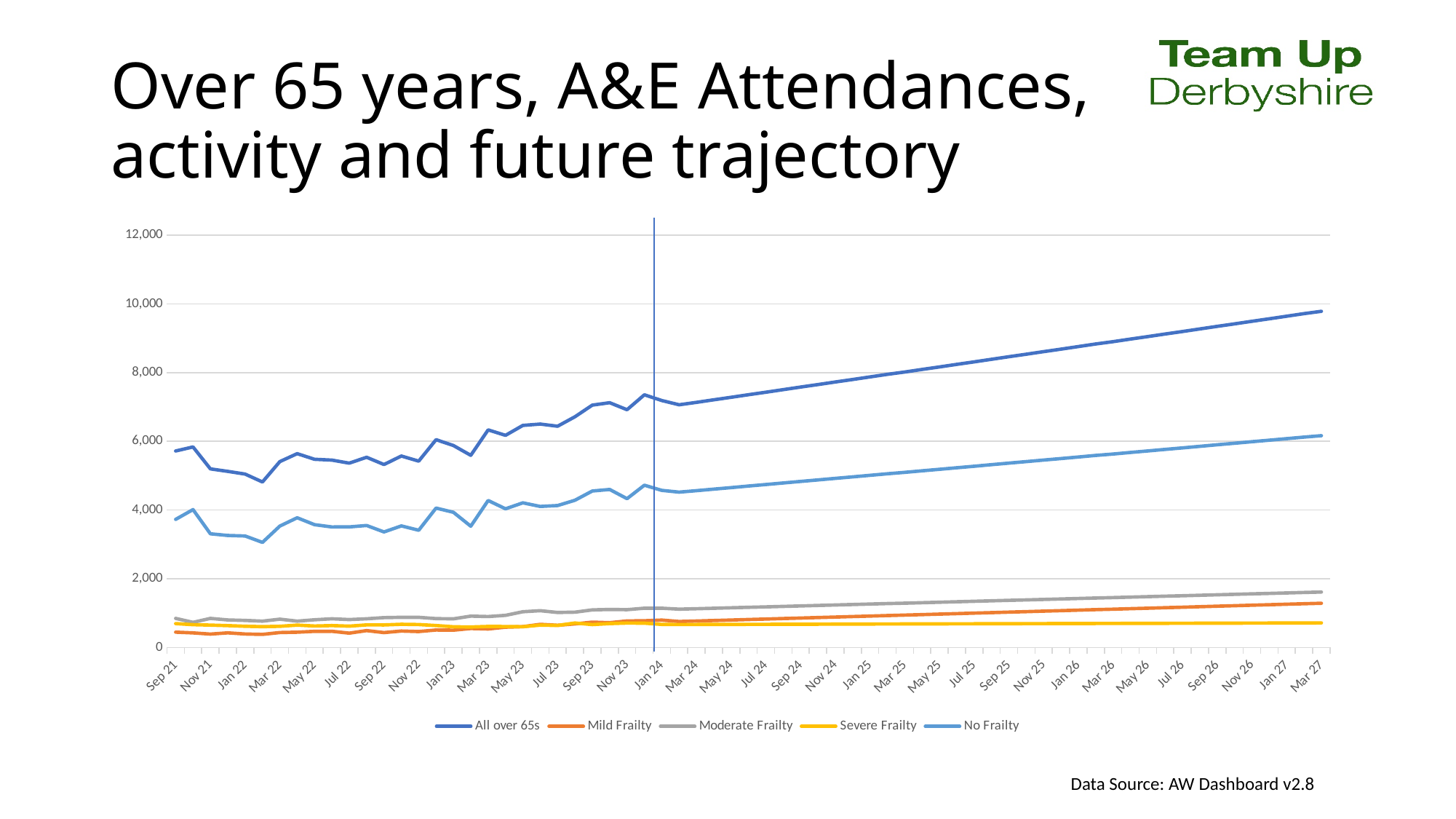
Which series has the lowest value at Mar 27? Severe Frailty How many series does the chart legend list? 5 What kind of chart is shown on the slide? line chart Is the value for Moderate Frailty at Mar 27 greater or less than 2,000? less At Mar 27, which is larger: No Frailty or Moderate Frailty? No Frailty Is the value for No Frailty at Mar 27 greater or less than 4,000? greater Is the value for All over 65s at Mar 27 greater or less than 8,000? greater What is the title of the slide containing the chart? Over 65 years, A&E Attendances, activity and future trajectory Which series has the lowest value at Sep 21? Mild Frailty Does the All over 65s line rise or fall from Jan 24 to Mar 27? rise Which series has the highest values across the whole chart? All over 65s